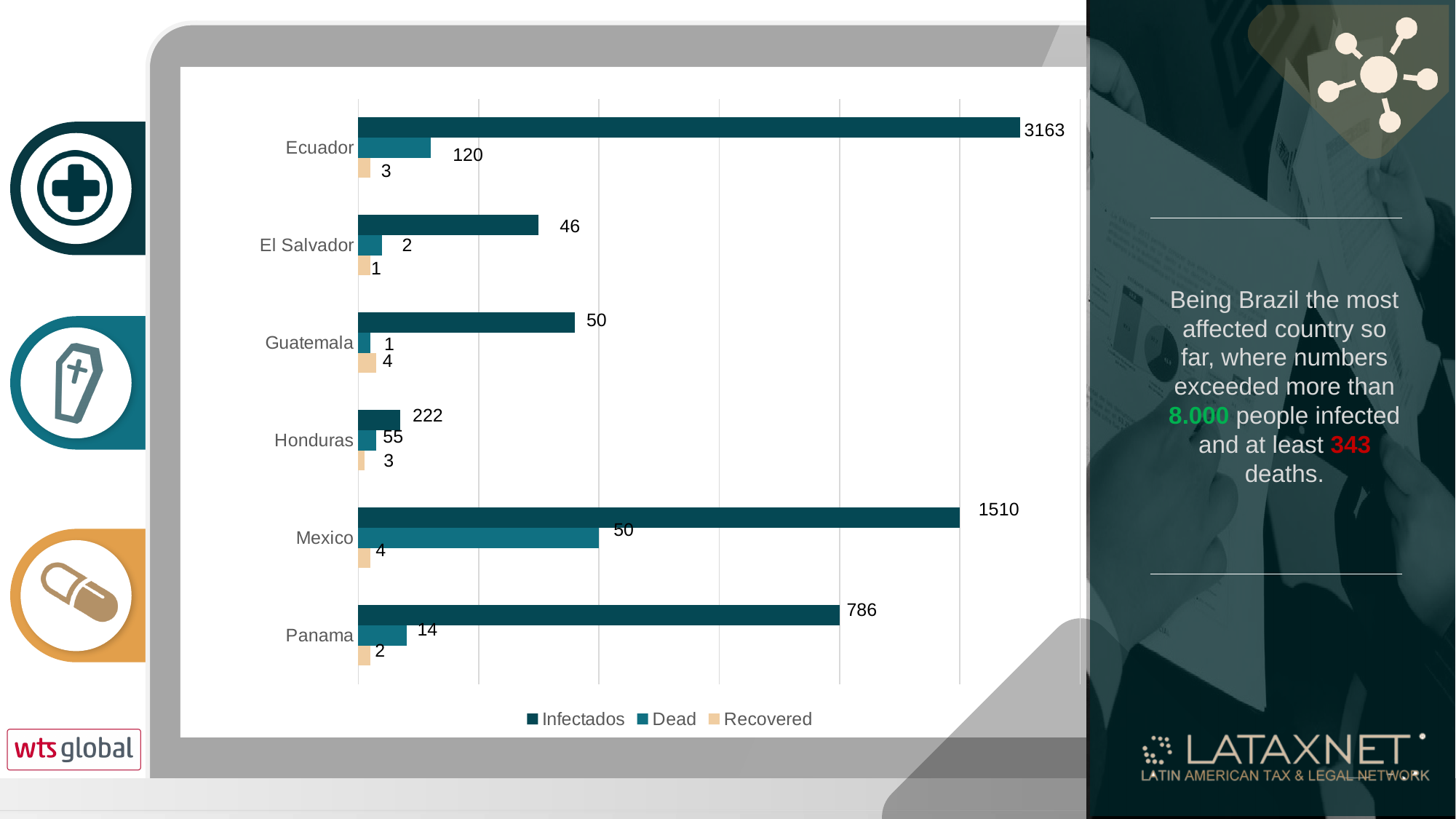
What is the Recovered value for Guatemala? 4 What is the Infectados value for Mexico? 1510 What kind of chart is shown on the slide? bar chart What is the Infectados value for Panama? 786 What is the difference between the Infectados values for Ecuador and Mexico? 1653 What is the Infectados value for Ecuador? 3163 What is the Dead value for Honduras? 55 What is the Dead value for Ecuador? 120 Which series is shown in the lightest (tan) colour in the legend? Recovered How many series does the legend list? 3 How many countries are shown on the chart? 6 Which country has the highest Infectados value? Ecuador